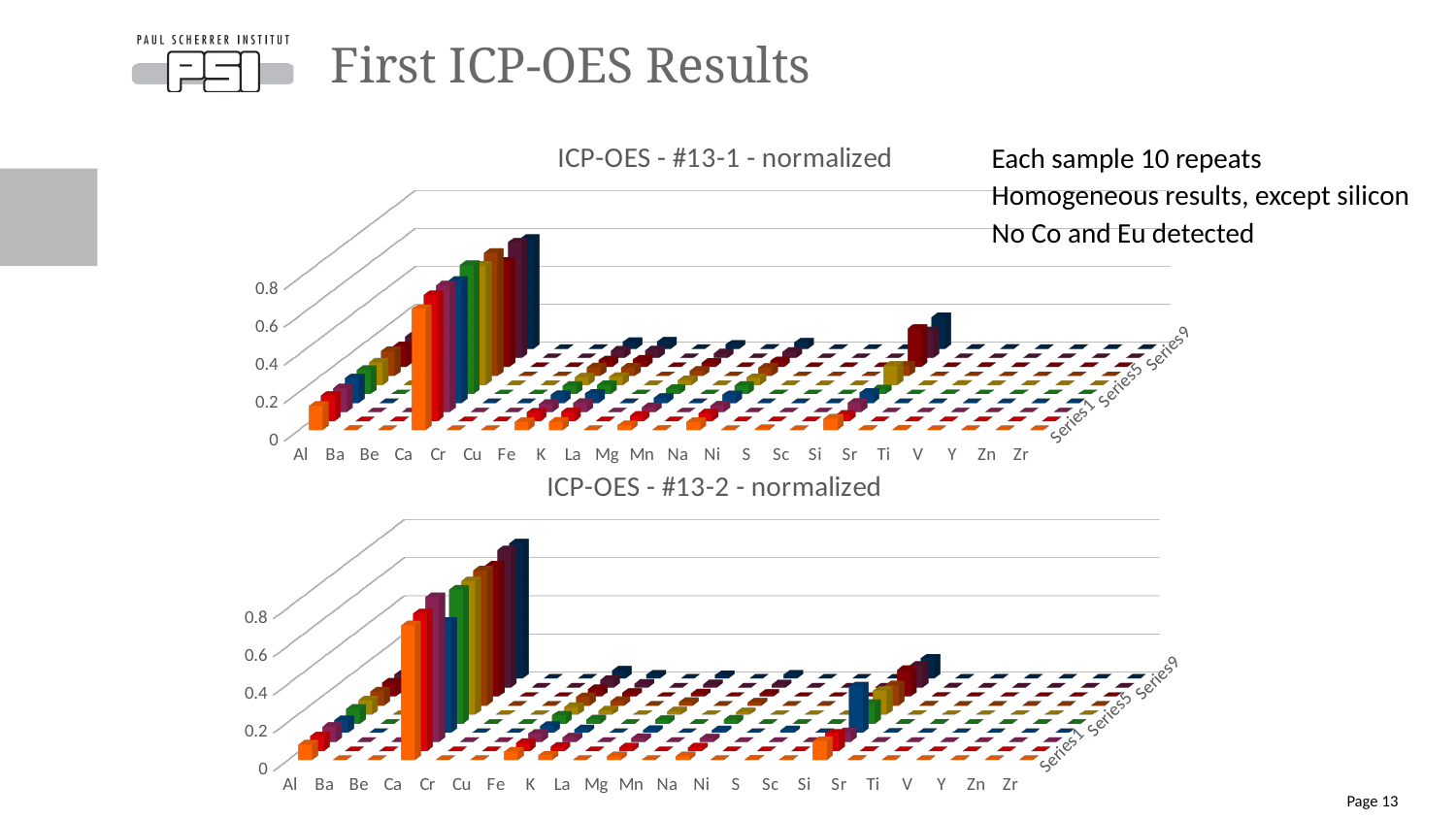
In the bottom chart (ICP-OES - #13-2 - normalized), are the values for Zr greater or less than 0.2? less In the bottom chart (ICP-OES - #13-2 - normalized), which element has the highest bars? Ca In the top chart (ICP-OES - #13-1 - normalized), which element has the highest bars? Ca In the top chart (ICP-OES - #13-1 - normalized), are the values for Ca greater or less than 0.4? greater What kind of chart is the top chart titled "ICP-OES - #13-1 - normalized"? bar chart What kind of chart is the bottom chart titled "ICP-OES - #13-2 - normalized"? bar chart In the bottom chart (ICP-OES - #13-2 - normalized), which is larger, the value for Ca or the value for Mg? Ca What is the title of the bottom chart on the slide? ICP-OES - #13-2 - normalized In the bottom chart (ICP-OES - #13-2 - normalized), how many element categories are shown on the x axis? 22 What is the title of the top chart on the slide? ICP-OES - #13-1 - normalized In the top chart (ICP-OES - #13-1 - normalized), which is larger, the value for Ca or the value for Zn? Ca In the top chart (ICP-OES - #13-1 - normalized), how many element categories are shown on the x axis? 22